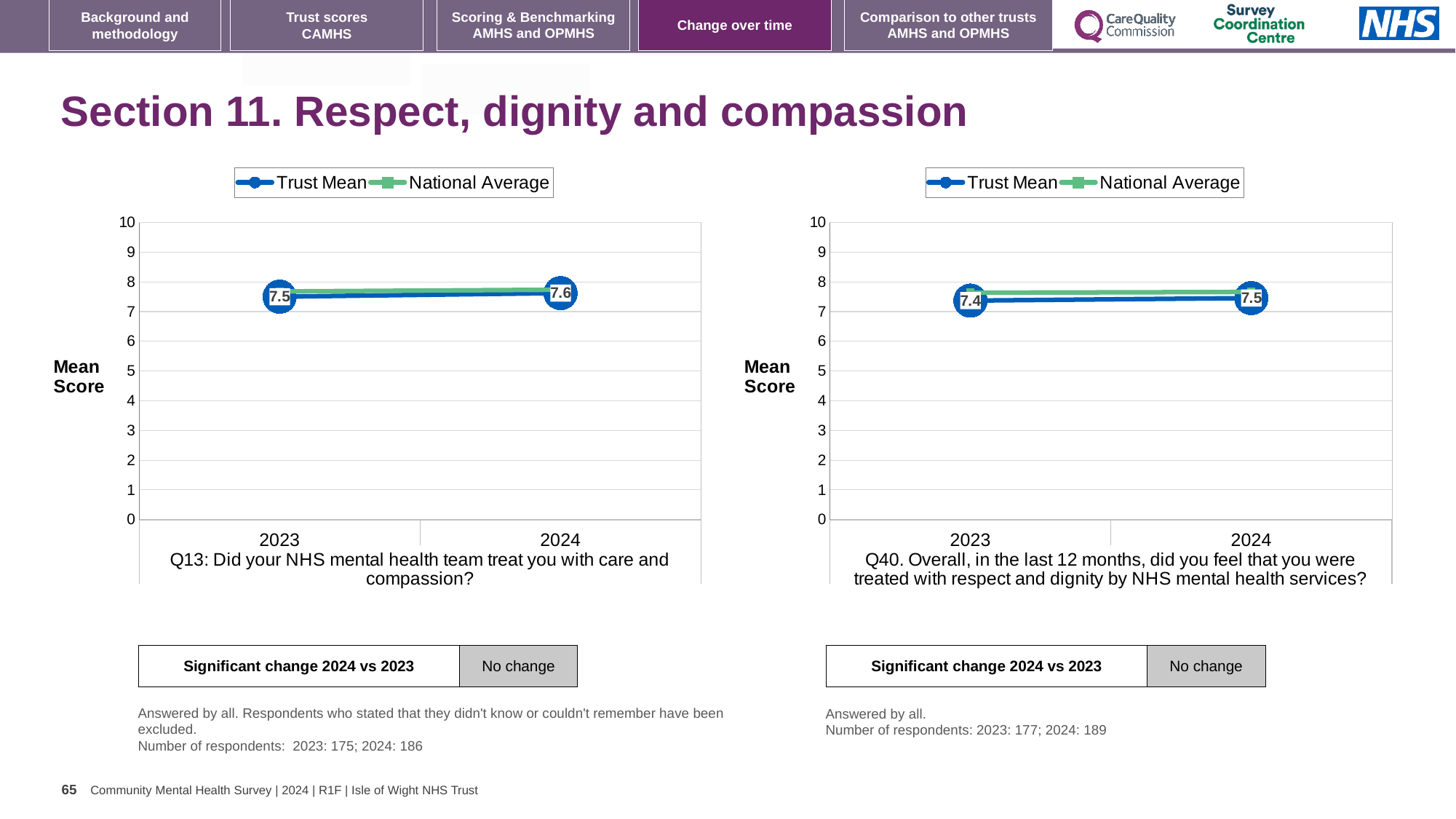
In the right chart (Q40), what is the Trust Mean score for 2023? 7.4 In the right chart (Q40), does the Trust Mean rise or fall from 2023 to 2024? rise In the left chart (Q13), what is the Trust Mean score for 2024? 7.6 How many series does the legend of the right chart (Q40) list? 2 In the left chart (Q13), by how much did the Trust Mean change from 2023 to 2024? 0.1 How many years are shown on the x axis of the left chart (Q13)? 2 In the left chart (Q13), which year has the higher Trust Mean score, 2023 or 2024? 2024 What type of chart is used on the left of the slide (Q13)? line chart What are the two series named in the legend of the left chart (Q13)? Trust Mean and National Average In the left chart (Q13), what is the Trust Mean score for 2023? 7.5 In the right chart (Q40), is the National Average value for 2024 greater or less than 5? greater In the right chart (Q40), what is the Trust Mean score for 2024? 7.5